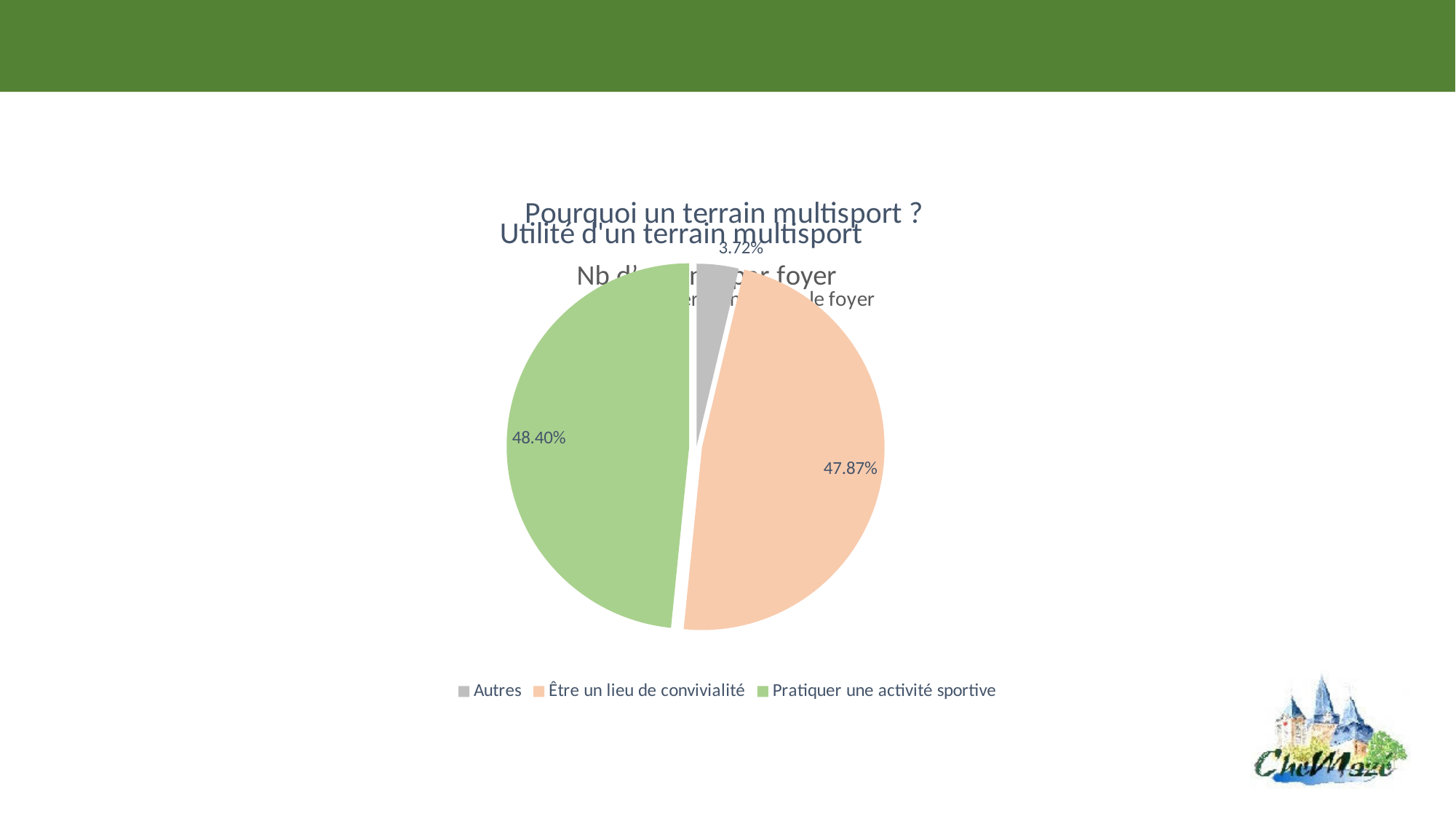
How many slices does the pie chart have? 3 Which category has the smallest slice of the pie chart? Autres Which is larger according to the data labels: "Pratiquer une activité sportive" or "Être un lieu de convivialité"? Pratiquer une activité sportive What colour is the slice for "Autres" in the pie chart? Grey What type of chart is shown on the slide? Pie chart What is the difference in percentage points between "Être un lieu de convivialité" and "Autres"? 44.15% What percentage of the pie chart is labelled for "Pratiquer une activité sportive"? 48.40% How many entries does the legend of the pie chart list? 3 What percentage of the pie chart is labelled for "Être un lieu de convivialité"? 47.87% Which category has the largest slice of the pie chart? Pratiquer une activité sportive What is the difference in percentage points between "Pratiquer une activité sportive" and "Être un lieu de convivialité"? 0.53% What percentage of the pie chart is labelled for "Autres"? 3.72%